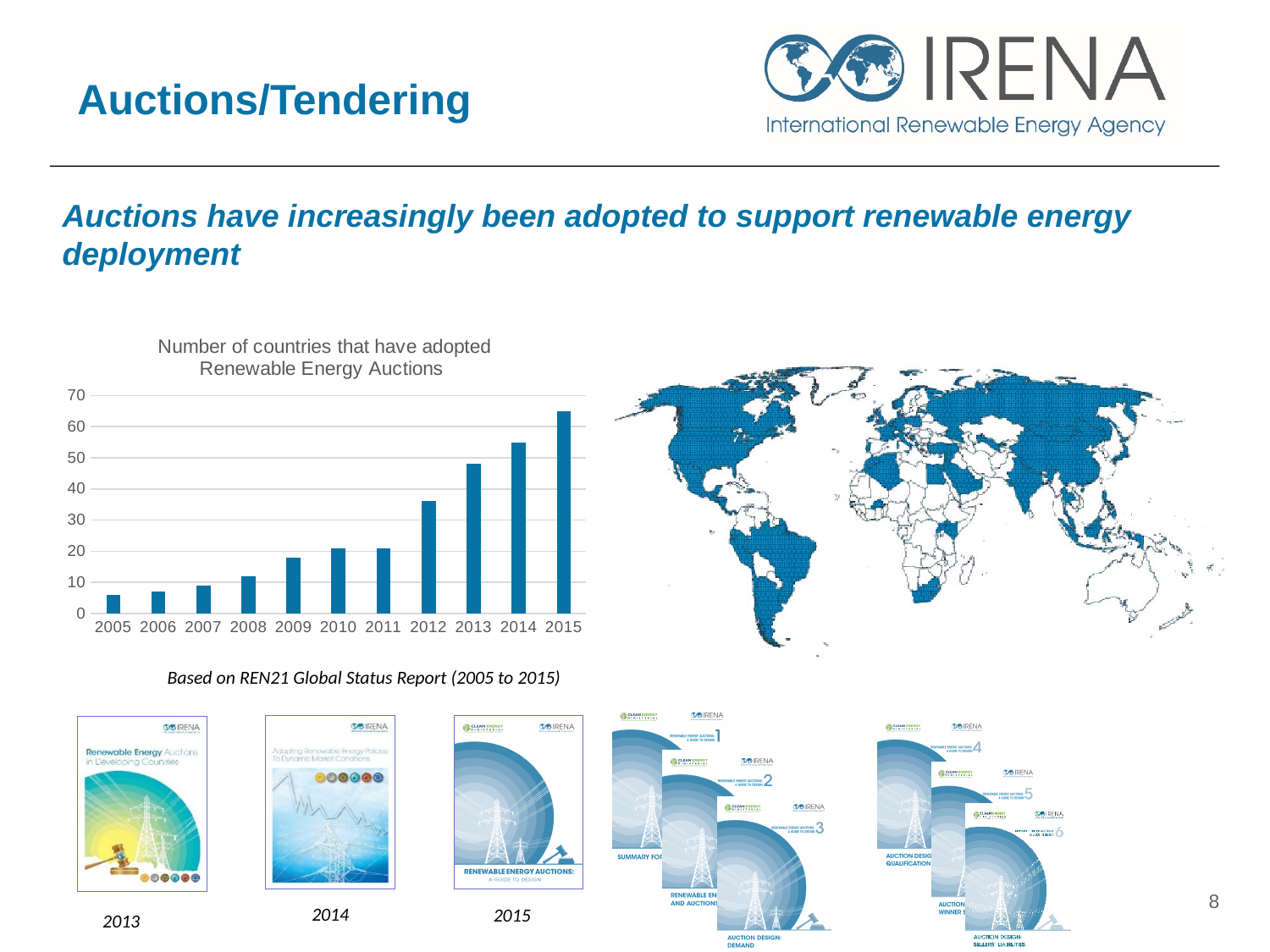
According to the note below the chart, what source is the chart based on? REN21 Global Status Report (2005 to 2015) Is the value for 2009 greater or less than 20? less What is the title of the chart? Number of countries that have adopted Renewable Energy Auctions Is the value for 2015 greater or less than 60? greater Is the value for 2014 greater or less than 50? greater Which year has the highest number of countries that have adopted renewable energy auctions? 2015 Do the values in the chart generally rise or fall from 2005 to 2015? rise What kind of chart is shown on the slide? bar chart How many years are shown on the x axis of the chart? 11 Which year has the larger value, 2011 or 2012? 2012